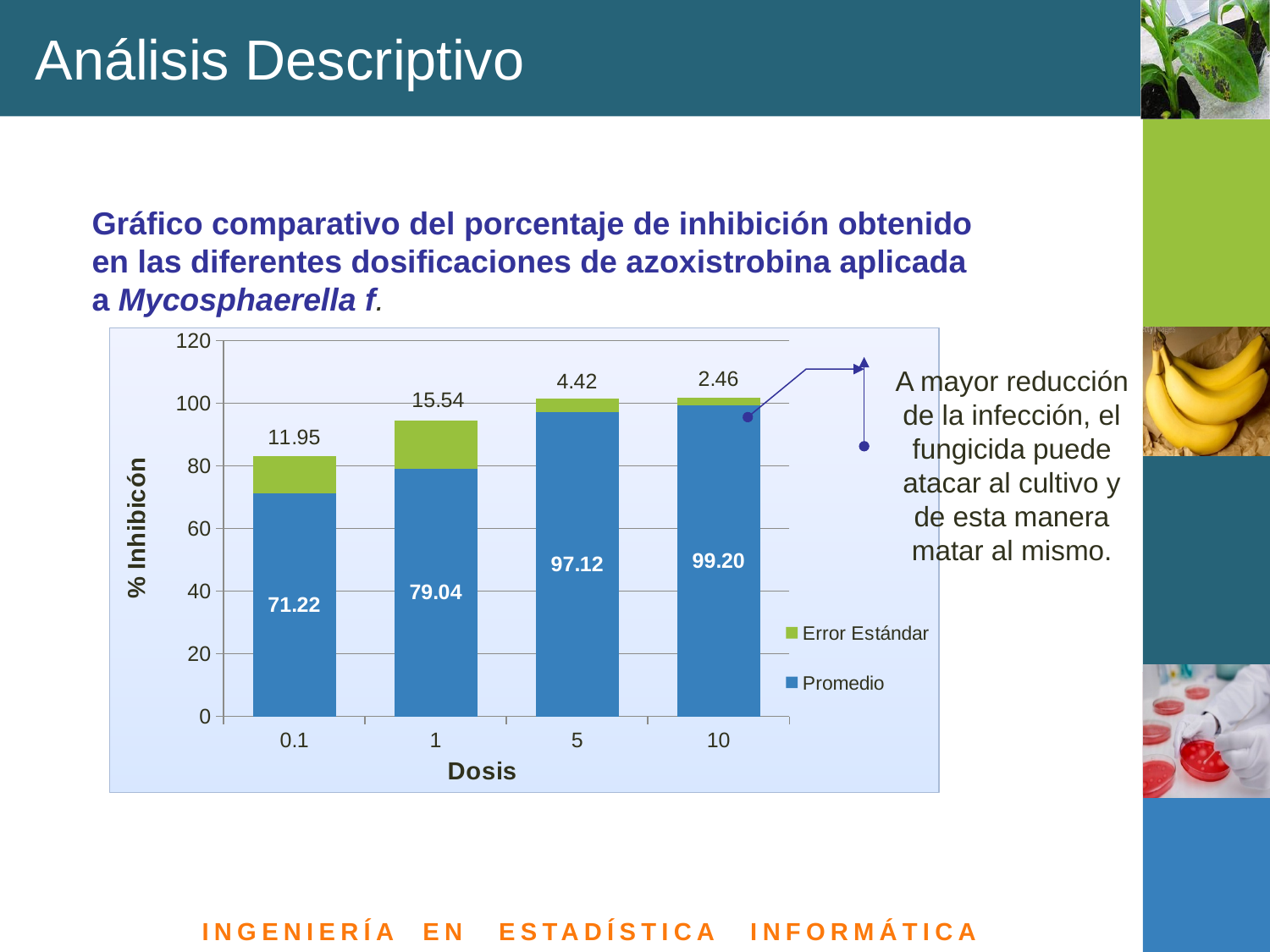
Which Dosis has the lowest Error Estándar value? 10 What is the difference between the Promedio values for Dosis 5 and Dosis 1? 18.08 What is the Promedio value for Dosis 0.1? 71.22 Which is larger, the Error Estándar for Dosis 0.1 or for Dosis 1? Dosis 1 What is the total of the stacked bar for Dosis 0.1 (Promedio plus Error Estándar)? 83.17 How many series does the legend list? 2 What is the Error Estándar value for Dosis 5? 4.42 Which Dosis has the highest Promedio value? 10 How many Dosis categories are shown on the x axis? 4 What is the Error Estándar value for Dosis 1? 15.54 What kind of chart is shown on the slide? Stacked bar chart What is the Promedio value for Dosis 10? 99.20